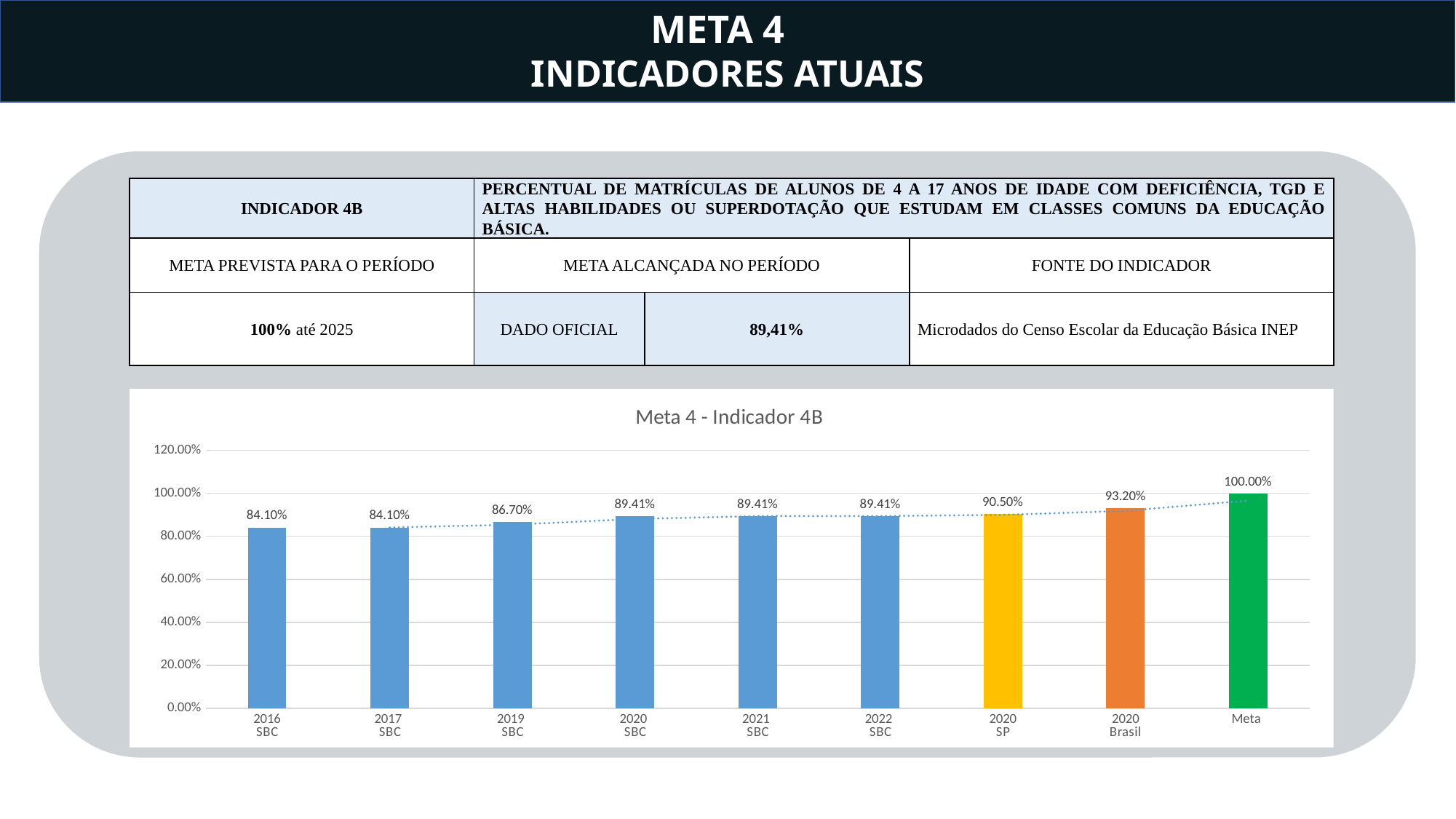
What kind of chart is shown on the slide? bar chart What is the difference between the values for 2020 Brasil and 2020 SP? 2.70% What is the title of the chart? Meta 4 - Indicador 4B What is the value for 2020 SP in the chart? 90.50% How many bars are plotted in the chart? 9 What is the value for 2020 Brasil in the chart? 93.20% Which category has the highest value in the chart? Meta What is the value for 2019 SBC in the chart? 86.70% What is the value for 2016 SBC in the chart? 84.10% Is the value for 2017 SBC greater or less than 100.00%? less What is the difference between the Meta value and the 2022 SBC value? 10.59% Which is larger, the value for 2020 SP or the value for 2020 SBC? 2020 SP